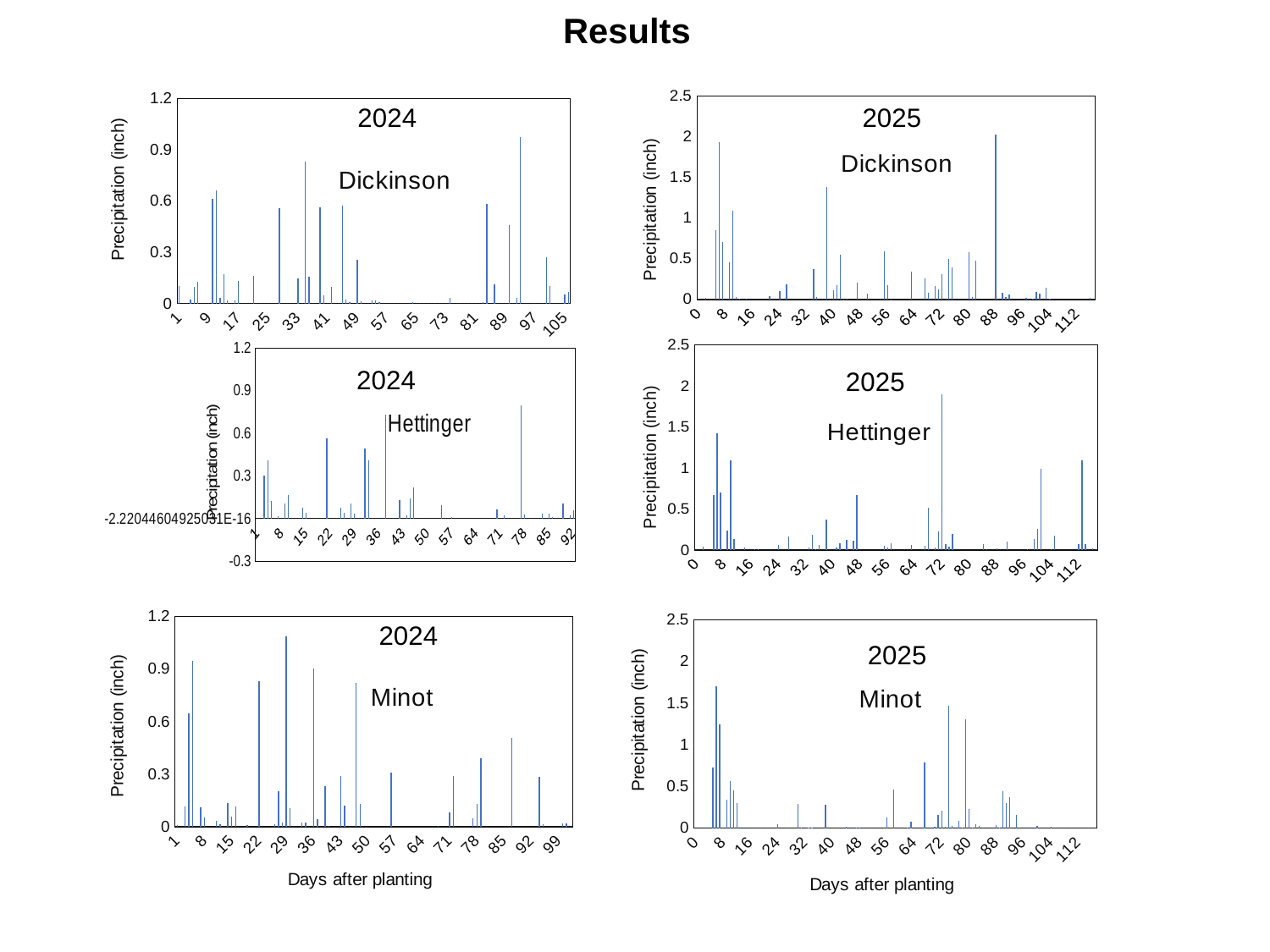
What is the highest y-axis tick value on the 2025 Minot chart? 2.5 In the 2025 Minot chart, is the tallest bar (near day 5) greater or less than 1? greater In the 2025 Dickinson chart, is the tallest bar (near day 88) greater or less than 1.5? greater What is the x-axis label shown beneath the Minot charts? Days after planting What is the y-axis label on the 2025 Dickinson chart? Precipitation (inch) What kind of chart is the 2024 Dickinson chart? bar chart In the 2024 Hettinger chart, is the tallest bar (near day 78) greater or less than 0.6? greater How many charts are shown on the slide? 6